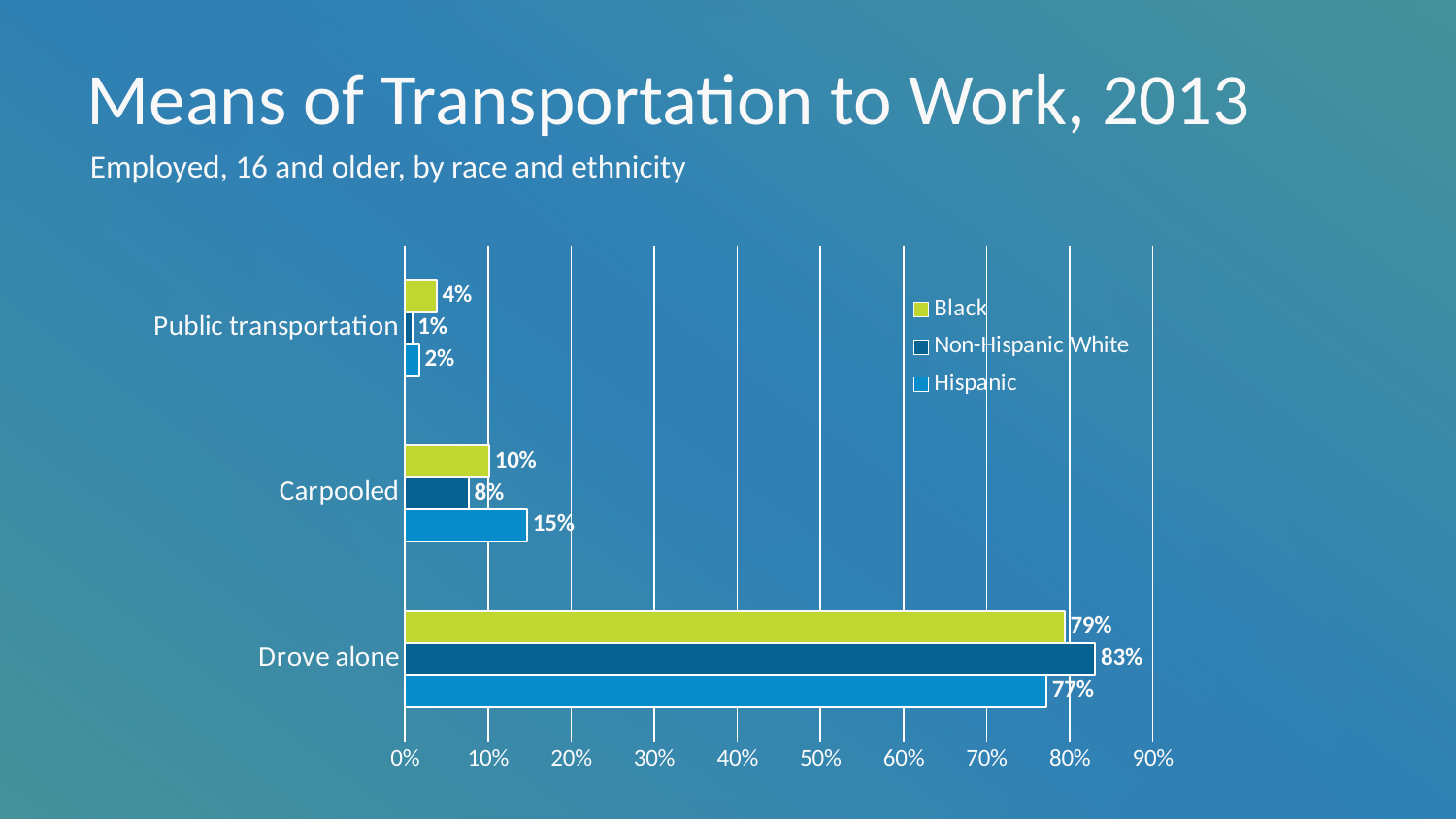
What percentage of Non-Hispanic White workers used public transportation? 1% What percentage of Black workers drove alone to work? 79% Which group has the highest share of workers who drove alone? Non-Hispanic White What is the difference between the Non-Hispanic White and Hispanic percentages for driving alone? 6% Which is larger: the Black share for public transportation or the Hispanic share for public transportation? Black How many series does the legend list? 3 How many means of transportation categories are shown on the chart? 3 What kind of chart is shown on the slide? Bar chart Which series is shown in green on the chart? Black Which group has the lowest share of workers who carpooled? Non-Hispanic White What is the title of the chart? Means of Transportation to Work, 2013 What percentage of Hispanic workers carpooled? 15%